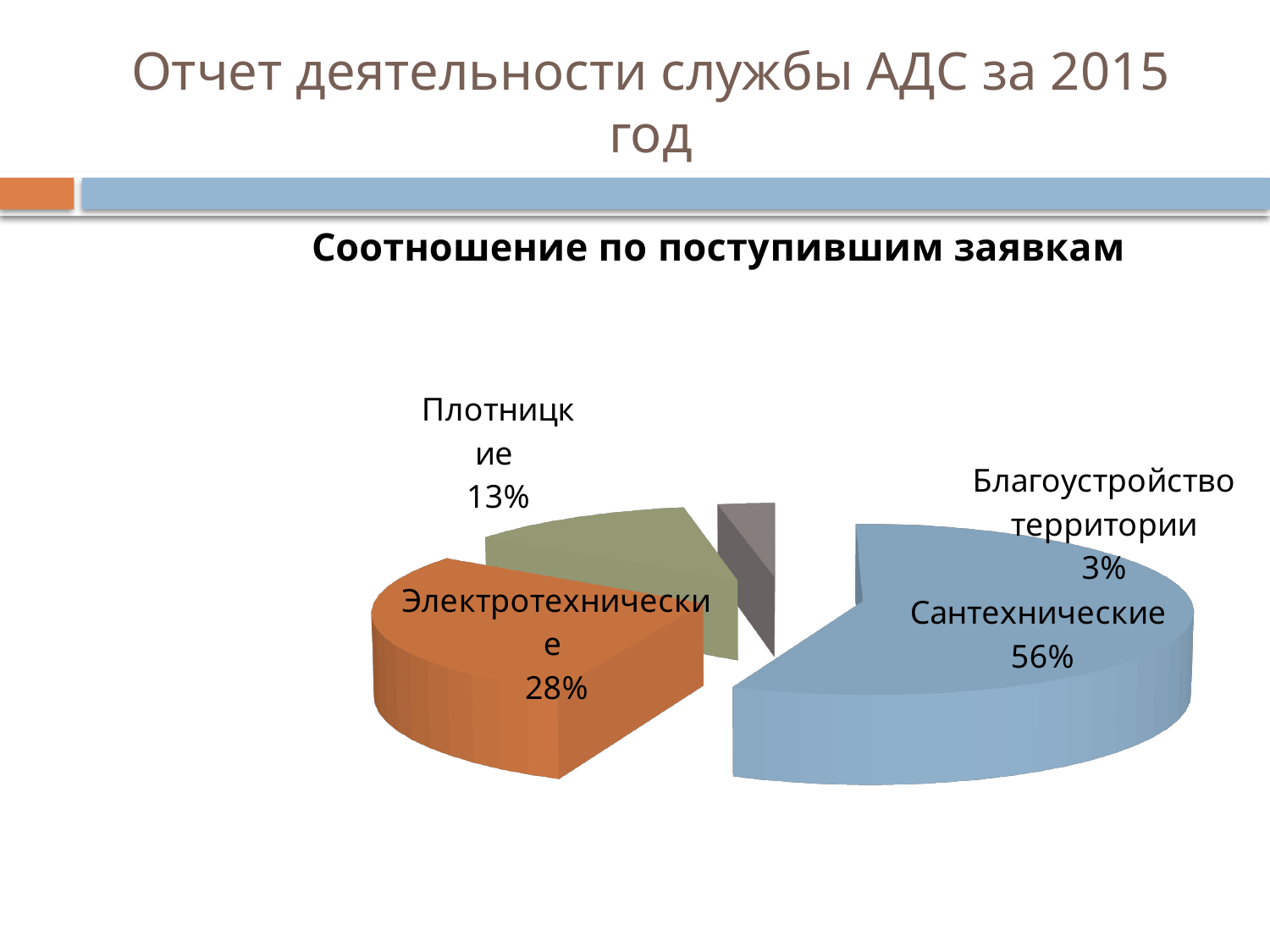
What is the value shown for Благоустройство территории? 3% Which category has the largest share of the pie? Сантехнические Which category has the smallest share of the pie? Благоустройство территории What is the title of the chart? Соотношение по поступившим заявкам How many categories are shown in the pie chart? 4 What kind of chart is shown on the slide? Pie chart What is the difference between the shares of Сантехнические and Электротехнические? 28% What share of the pie does the Сантехнические slice represent? 56% Which is larger, the share for Электротехнические or the share for Плотницкие? Электротехнические What is the difference between the shares of Плотницкие and Благоустройство территории? 10% What is the value shown for Плотницкие? 13% What is the value shown for Электротехнические? 28%